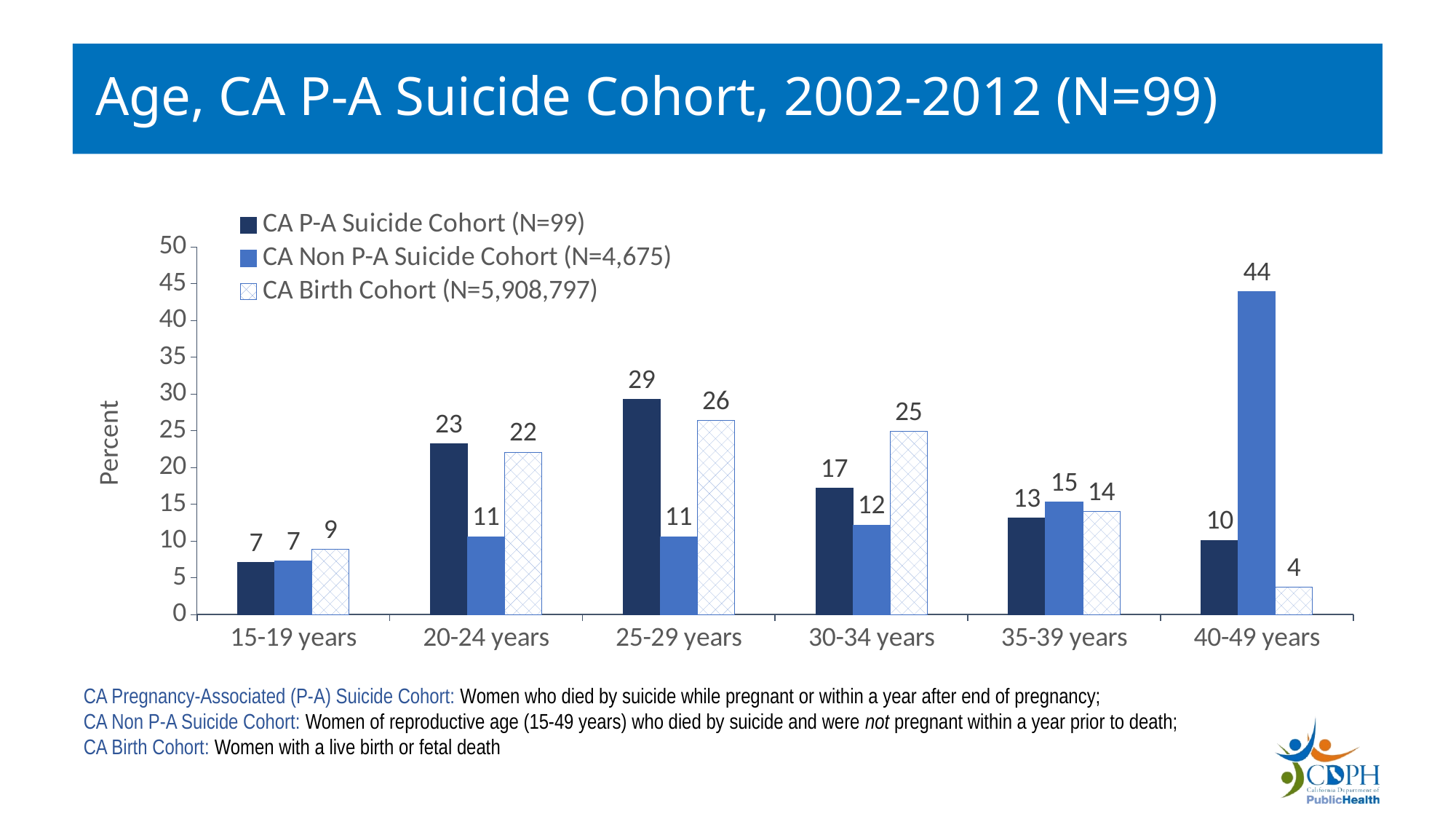
What is the label of the y axis? Percent Which age group has the lowest value for the CA Birth Cohort? 40-49 years How many age groups are shown on the x axis? 6 What is the value for the CA P-A Suicide Cohort in the 25-29 years age group? 29 How many series does the legend list? 3 What kind of chart is shown on the slide? Bar chart Which age group has the highest value for the CA P-A Suicide Cohort? 25-29 years Is the value for the CA Non P-A Suicide Cohort in the 40-49 years age group greater or less than 40? greater In the 20-24 years age group, which is larger: the CA P-A Suicide Cohort value or the CA Non P-A Suicide Cohort value? CA P-A Suicide Cohort What is the value for the CA Birth Cohort in the 30-34 years age group? 25 What is the difference between the CA Non P-A Suicide Cohort and the CA Birth Cohort values in the 40-49 years age group? 40 What is the value for the CA Non P-A Suicide Cohort in the 40-49 years age group? 44